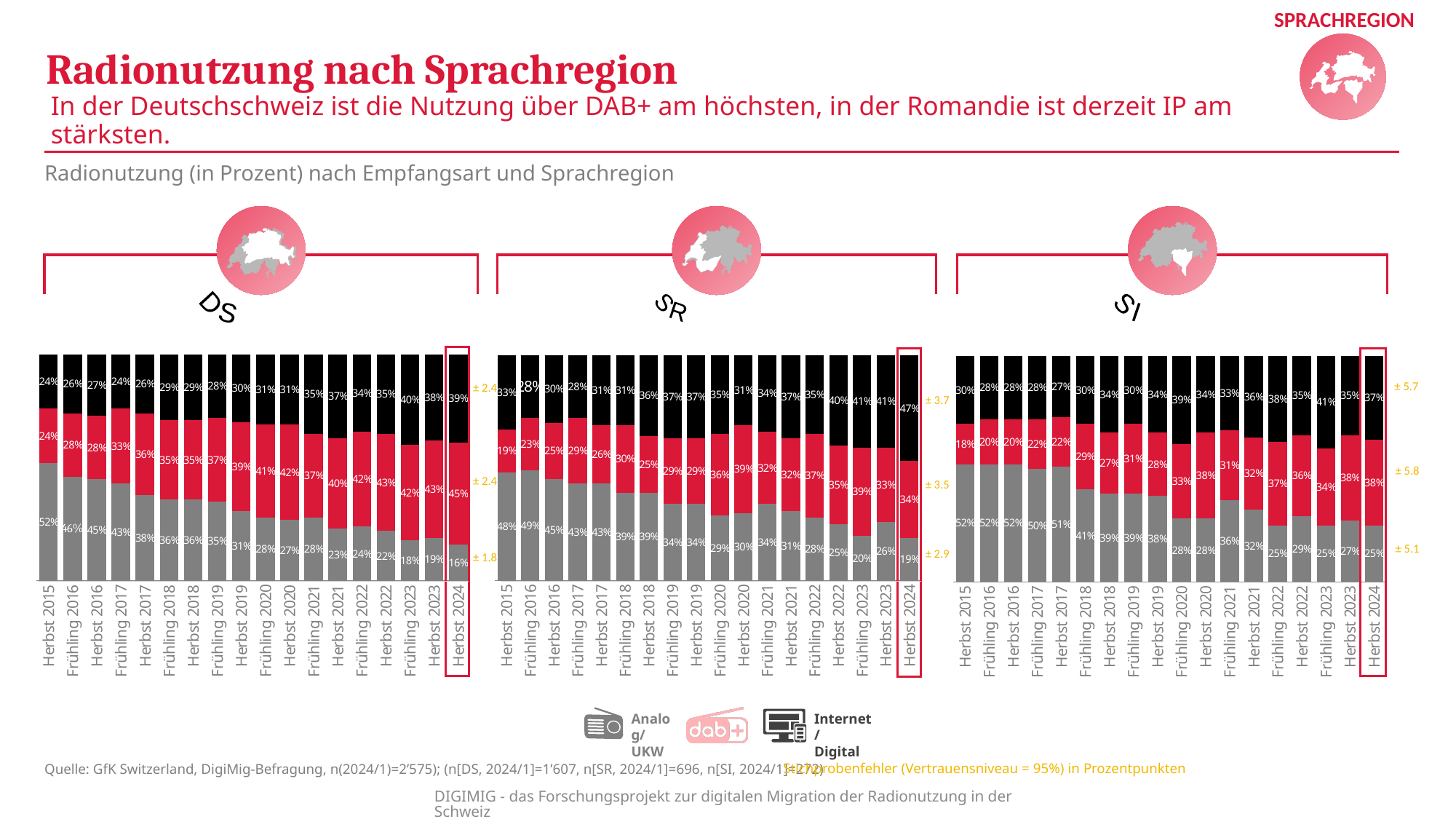
In the DS chart, what is the Analog/UKW share for Herbst 2015? 52% What kind of chart is used for each language region on this slide? Stacked bar chart Which language region has the lowest Analog/UKW share in Herbst 2024? DS Which language region has the highest Internet/Digital share in Herbst 2024? SR Which three reception types does the legend list? Analog/UKW, DAB+, Internet/Digital How many survey periods (bars) are shown in the DS chart? 18 In the DS chart, does the Analog/UKW share rise or fall from Herbst 2015 to Herbst 2024? Fall In the SR chart for Herbst 2024, which is larger: the Internet/Digital share or the DAB+ share? Internet/Digital In the SR chart, what is the Internet/Digital share for Herbst 2024? 47% In the DS chart, what is the Analog/UKW share for Herbst 2024? 16% In the SI chart, what is the DAB+ share for Herbst 2024? 38% In the DS chart for Herbst 2024, what is the difference between the DAB+ share and the Analog/UKW share? 29 percentage points